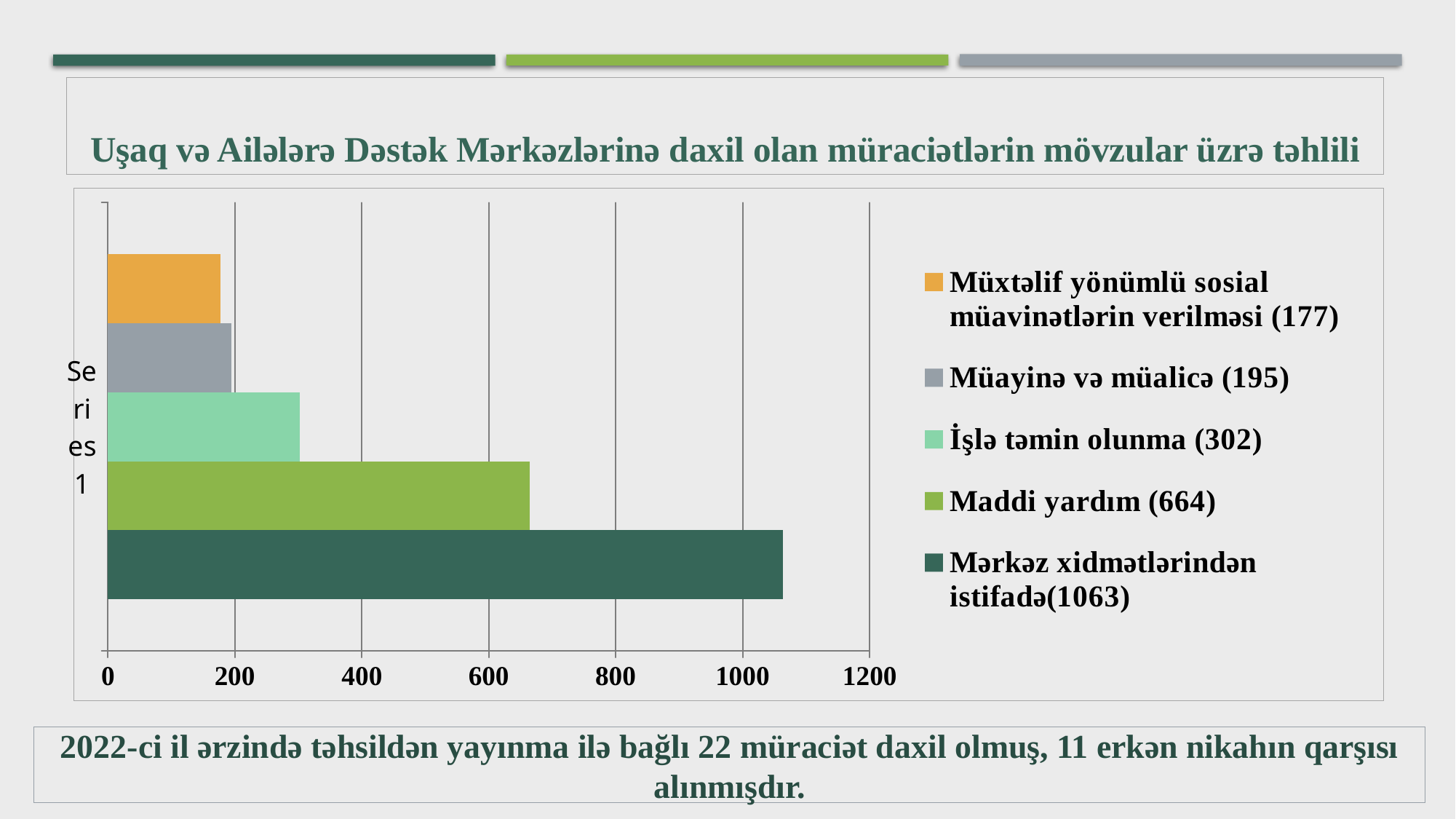
What is the value for "İşlə təmin olunma"? 302 What is the value for "Mərkəz xidmətlərindən istifadə"? 1063 What is the value for "Müayinə və müalicə"? 195 What kind of chart is shown on the slide? bar chart How many series does the legend list? 5 What is the difference between the values for "Mərkəz xidmətlərindən istifadə" and "Maddi yardım"? 399 What is the title of the chart? Uşaq və Ailələrə Dəstək Mərkəzlərinə daxil olan müraciətlərin mövzular üzrə təhlili What is the value for "Maddi yardım"? 664 Is the value for "Maddi yardım" greater or less than 600? greater Which is larger, the value for "İşlə təmin olunma" or the value for "Müayinə və müalicə"? İşlə təmin olunma Which category has the lowest value? Müxtəlif yönümlü sosial müavinətlərin verilməsi Which category has the highest value? Mərkəz xidmətlərindən istifadə